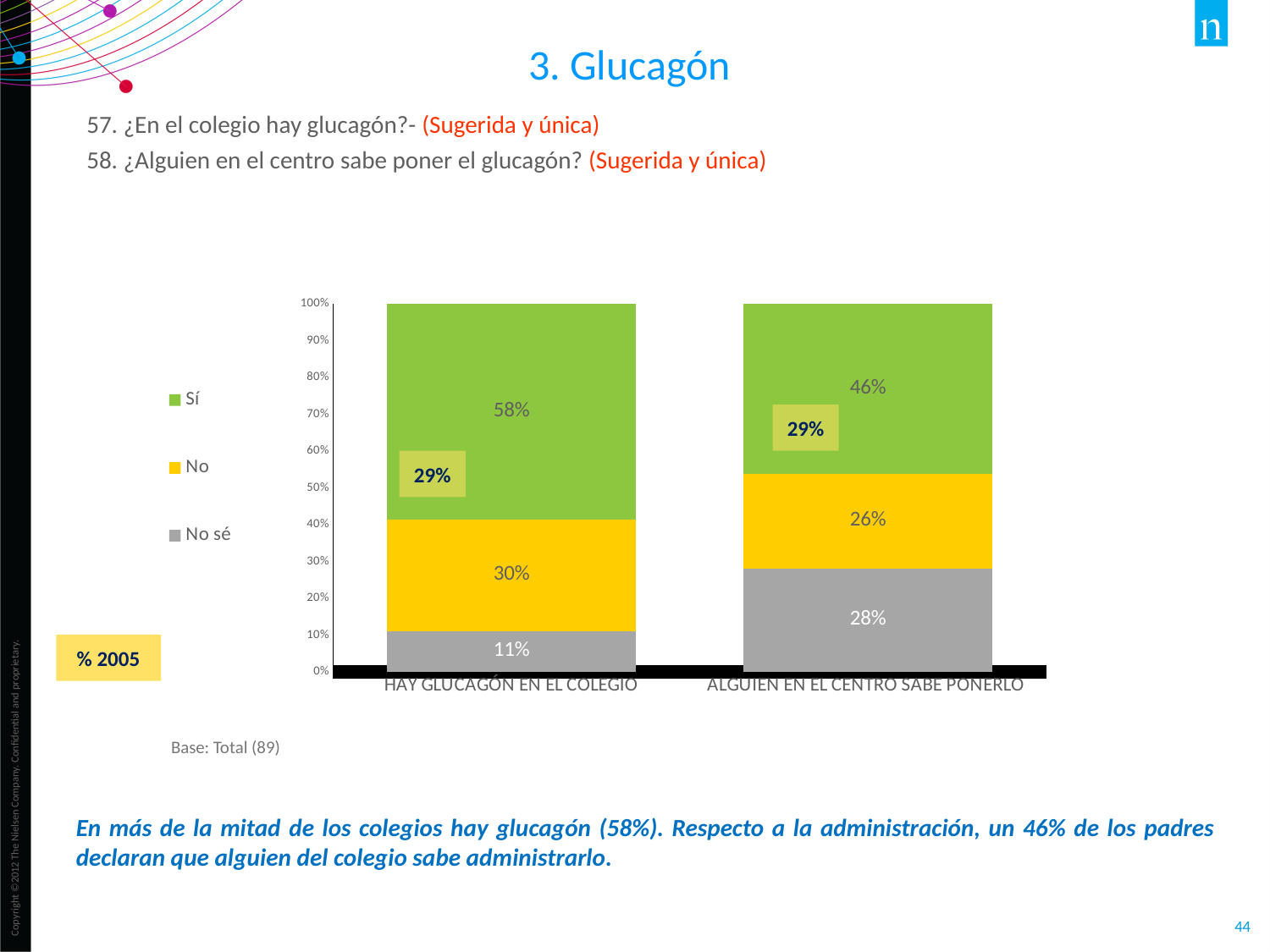
What is the value for "No sé" in the "HAY GLUCAGÓN EN EL COLEGIO" bar? 11% What kind of chart is shown on the slide? Stacked bar chart Which category has the higher "Sí" value? HAY GLUCAGÓN EN EL COLEGIO What is the value for "No sé" in the "ALGUIEN EN EL CENTRO SABE PONERLO" bar? 28% What is the difference between the "Sí" values for "HAY GLUCAGÓN EN EL COLEGIO" and "ALGUIEN EN EL CENTRO SABE PONERLO"? 12% What is the value for "Sí" in the "HAY GLUCAGÓN EN EL COLEGIO" bar? 58% What is the value for "Sí" in the "ALGUIEN EN EL CENTRO SABE PONERLO" bar? 46% Which legend entry is shown in green? Sí What is the total of the "ALGUIEN EN EL CENTRO SABE PONERLO" stacked bar? 100% How many categories are shown on the x axis? 2 What is the value for "No" in the "HAY GLUCAGÓN EN EL COLEGIO" bar? 30% How many series does the legend list? 3